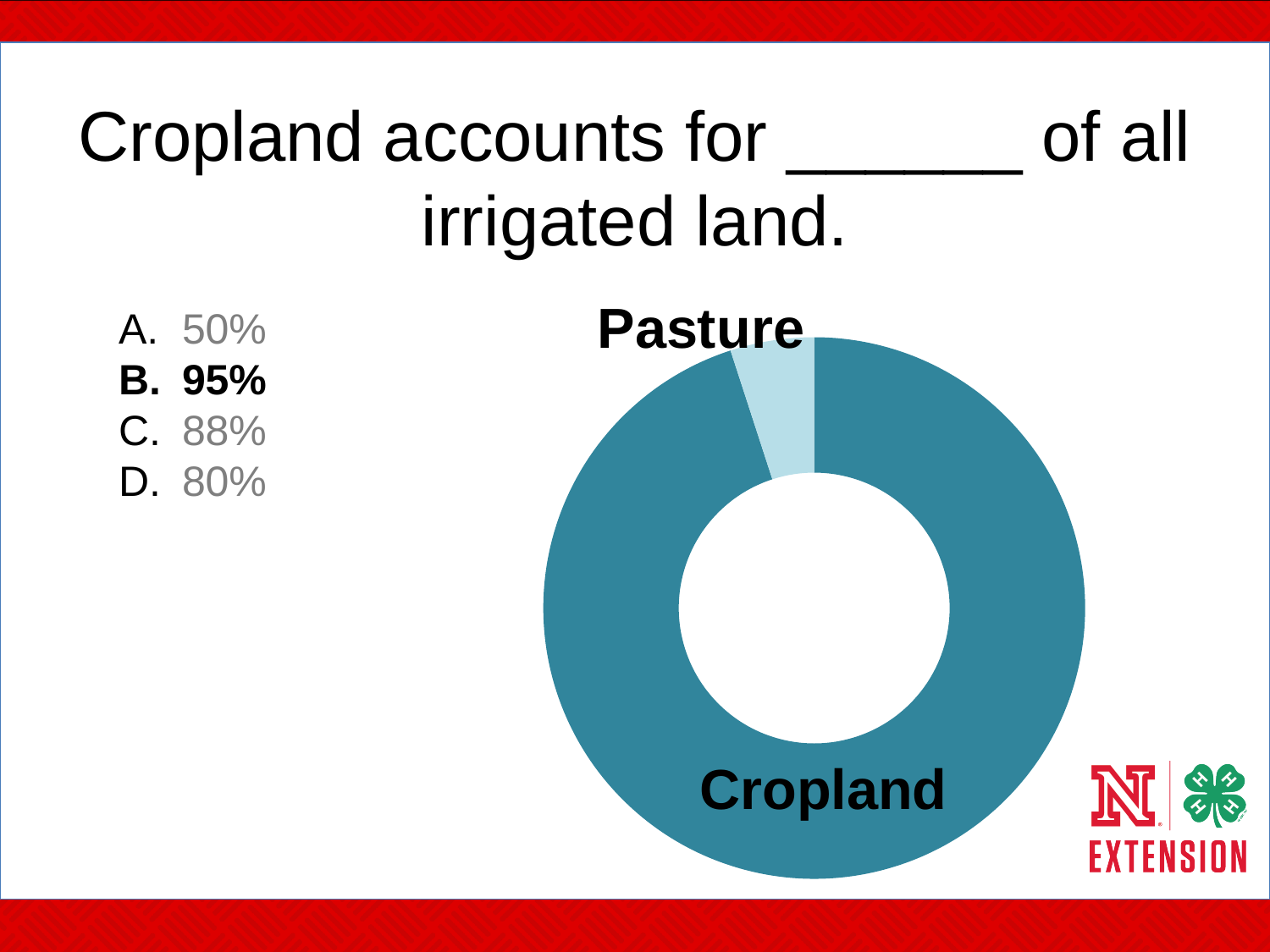
What colour is the Cropland slice? dark teal blue Which category has the largest slice in the chart? Cropland Which category has the smallest slice in the chart? Pasture How many categories (slices) does the chart show? 2 Is the Cropland slice greater or less than half of the chart? greater Which category is labelled at the top of the chart? Pasture What kind of chart is shown on the slide? donut (pie) chart Which slice is larger, Cropland or Pasture? Cropland